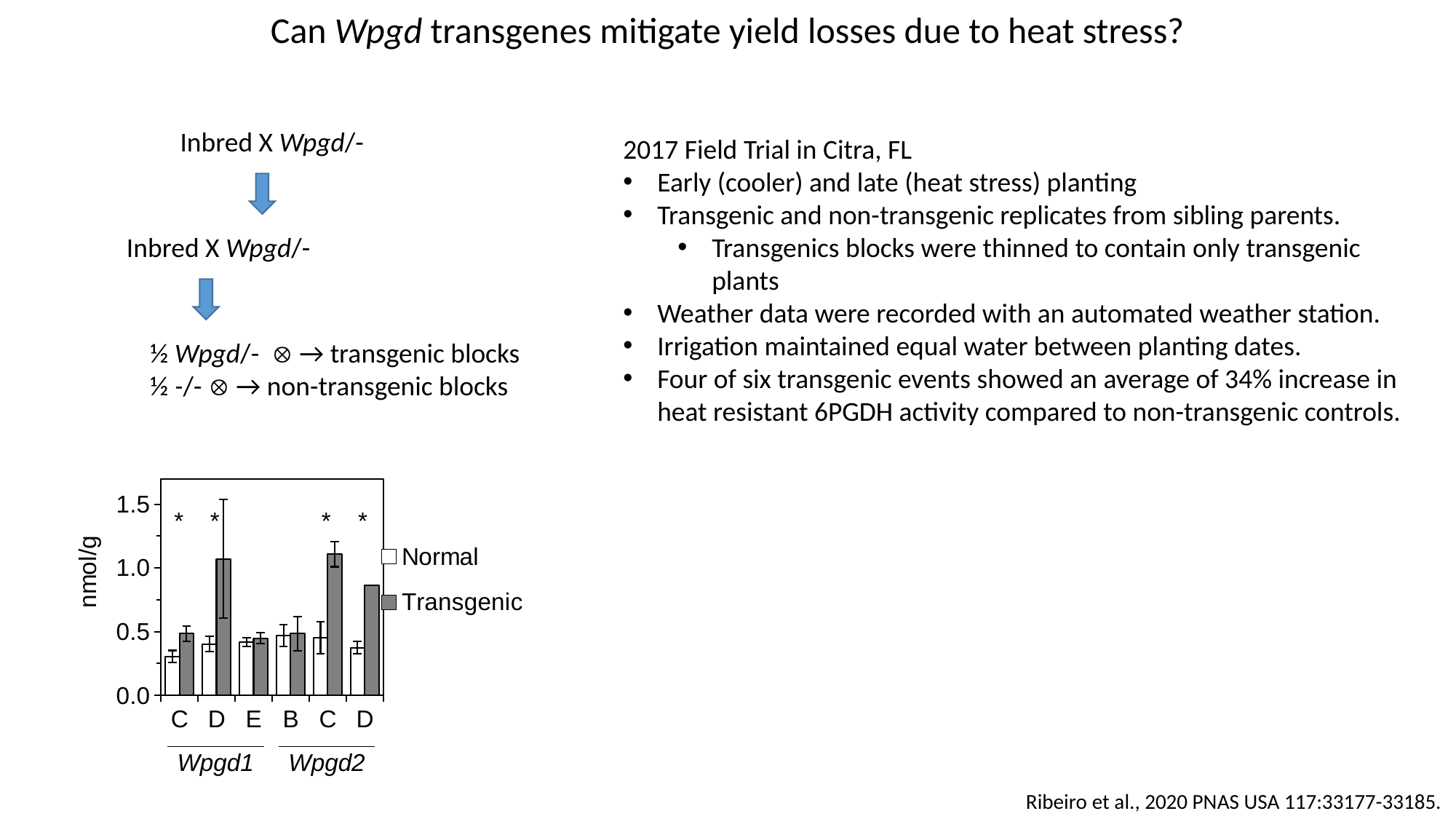
Is the Transgenic value for Wpgd2 event D greater or less than 1.0? less What kind of chart is shown on the slide? bar chart Is the Transgenic value for Wpgd2 event C greater or less than 1.0? greater For Wpgd1 event D, which is larger, the Normal or the Transgenic value? Transgenic Is the Transgenic value for Wpgd2 event D greater or less than 0.5? greater What is the label on the y axis of the chart? nmol/g For Wpgd2 event C, which is larger, the Normal or the Transgenic value? Transgenic How many series does the chart's legend list? 2 Which legend entry is shown with grey bars? Transgenic For Wpgd2 event D, which is larger, the Normal or the Transgenic value? Transgenic How many categories (events) are shown along the x axis of the chart? 6